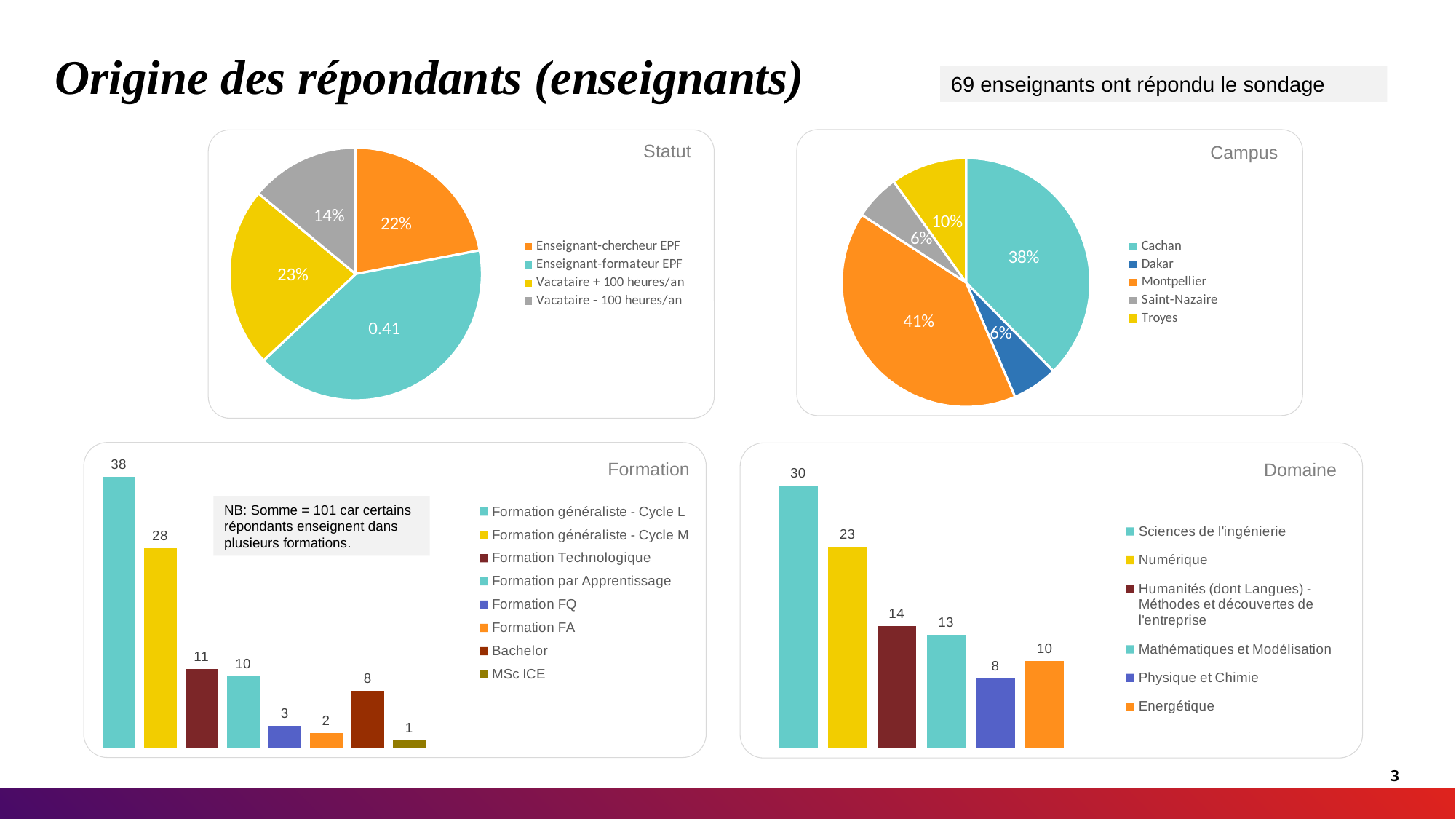
In the Campus pie chart, what share is shown for Troyes? 10% In the Formation chart, what is the value for Formation généraliste - Cycle M? 28 In the Campus pie chart, which campus has the largest share? Montpellier In the Statut pie chart, what value is printed on the Enseignant-formateur EPF slice? 0.41 How many entries does the legend of the Campus pie chart list? 5 How many bars are there in the Domaine chart? 6 In the Formation chart, which formation has the lowest value? MSc ICE What kind of chart is the Domaine chart? Bar chart In the Formation chart, what is the difference between Formation généraliste - Cycle L and Formation généraliste - Cycle M? 10 In the Domaine chart, what is the value for Numérique? 23 In the Statut pie chart, what share is shown for Vacataire + 100 heures/an? 23% In the Domaine chart, which is larger: Physique et Chimie or Energétique? Energétique